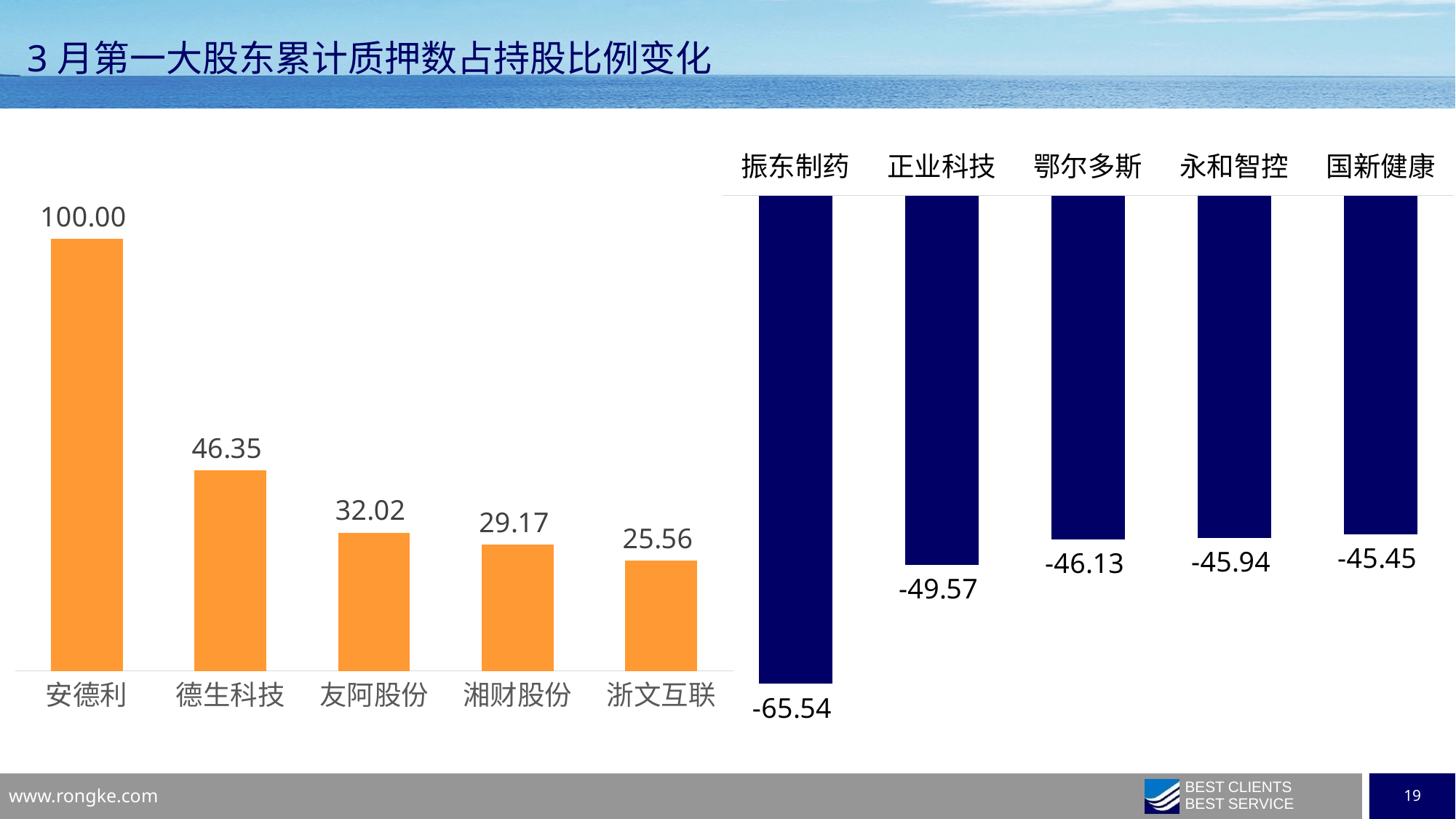
In the left chart (orange bars), what is the value for 安德利? 100.00 What kind of chart is the left chart (orange bars)? Bar chart In the right chart (dark blue bars), what is the difference between the values for 正业科技 and 鄂尔多斯? 3.44 In the left chart (orange bars), what is the value for 友阿股份? 32.02 In the left chart (orange bars), which is larger, the value for 湘财股份 or 浙文互联? 湘财股份 In the right chart (dark blue bars), what is the value for 国新健康? -45.45 In the left chart (orange bars), which category has the lowest value? 浙文互联 In the right chart (dark blue bars), what is the value for 振东制药? -65.54 Do the values in the left chart (orange bars) rise or fall from left to right? Fall How many categories are shown in the right chart (dark blue bars)? 5 In the right chart (dark blue bars), which category has the lowest value? 振东制药 In the left chart (orange bars), what is the difference between the values for 安德利 and 德生科技? 53.65